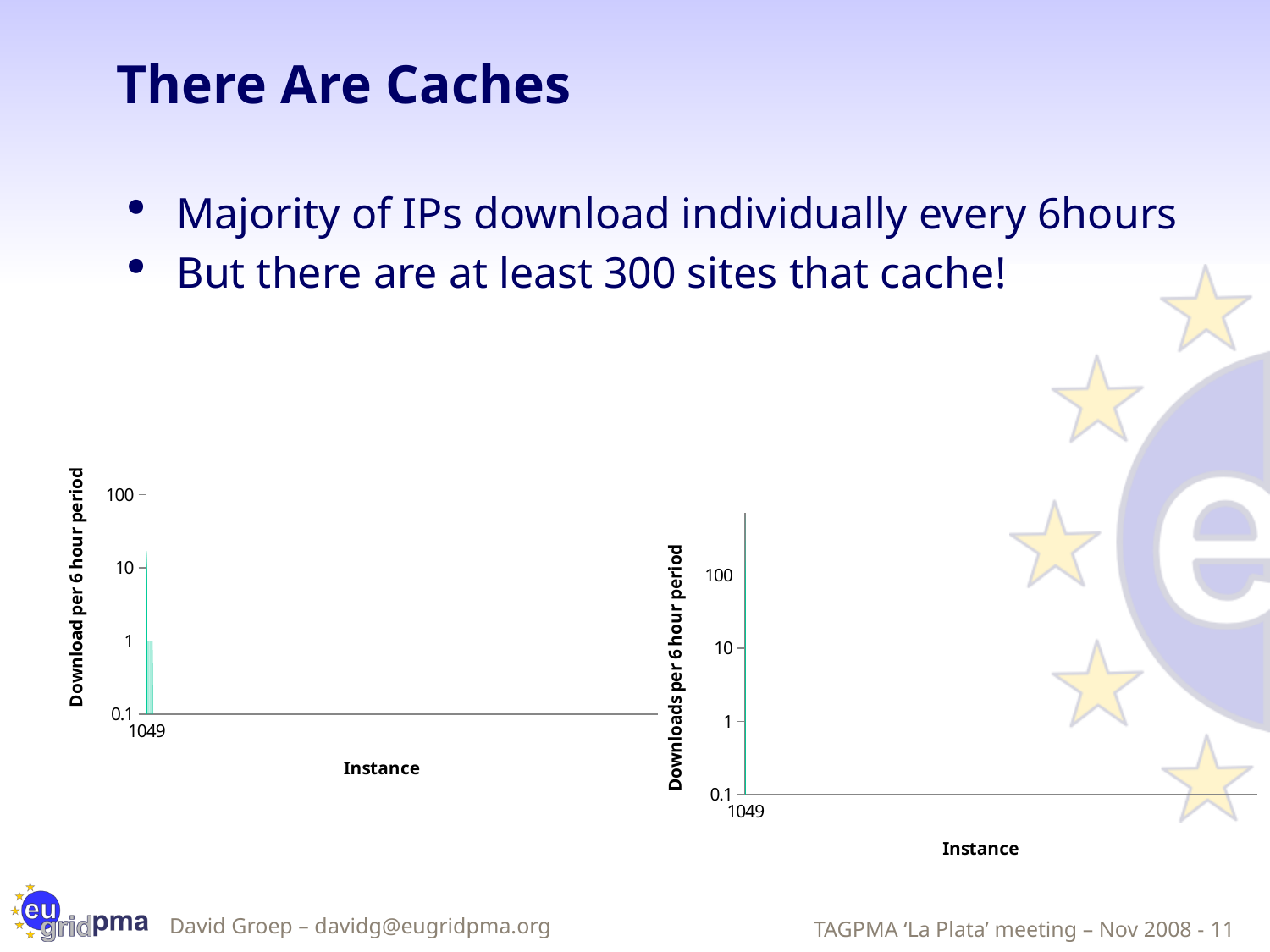
On the left chart, is the highest plotted value greater or less than 100? greater On the right chart, is the highest plotted value greater or less than 1? greater On the left chart, is the highest plotted value greater or less than 10? greater On the right chart, what is the x-axis title? Instance On the left chart, what is the y-axis title? Download per 6 hour period